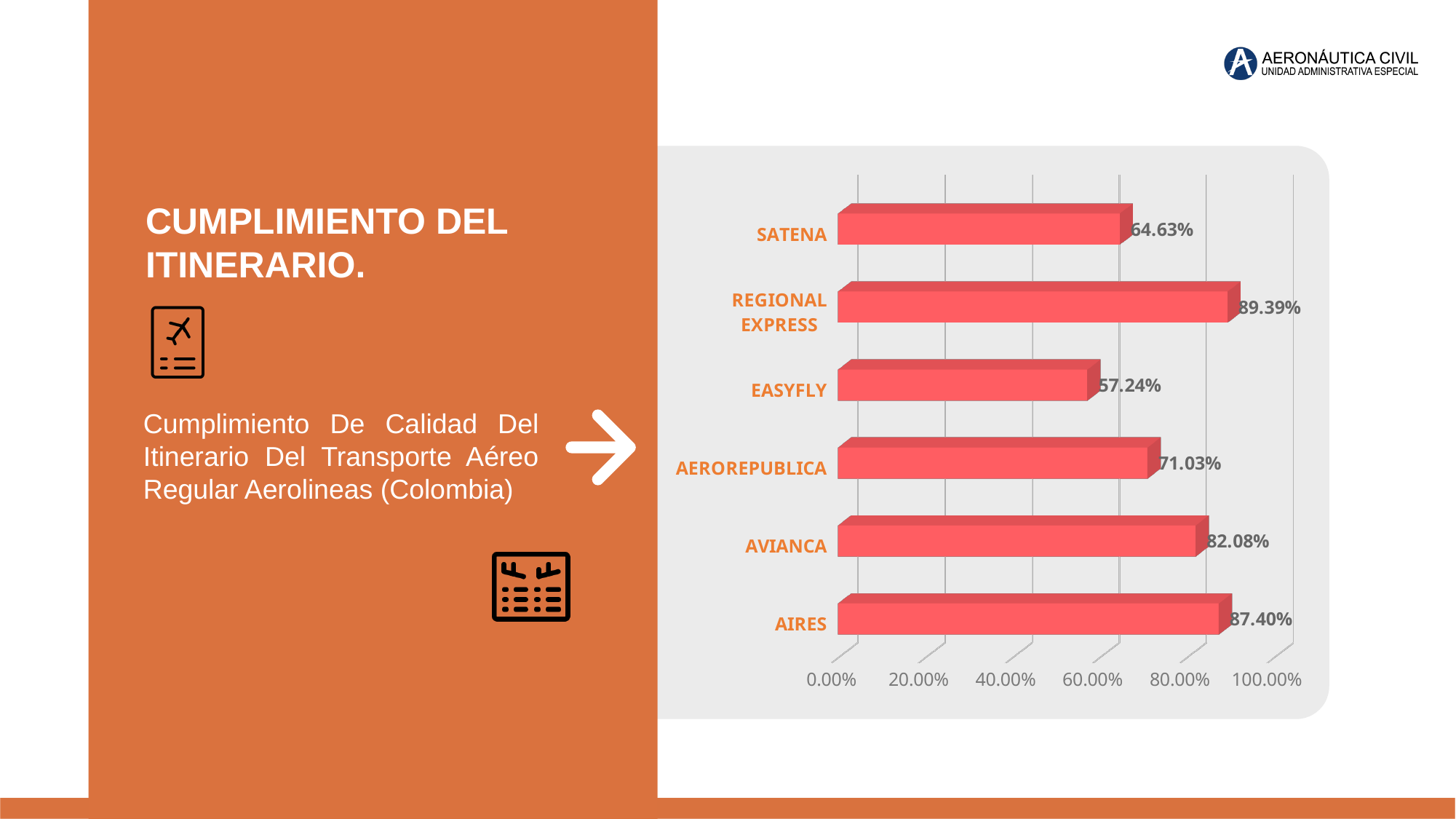
What is the value for EASYFLY? 57.24% What is the value for AEROREPUBLICA? 71.03% Which airline has the lowest value? EASYFLY What is the value for REGIONAL EXPRESS? 89.39% What kind of chart is shown on the slide? bar chart Is the value for AVIANCA greater or less than 80.00%? greater What is the difference between the values for AVIANCA and AIRES? 5.32% How many airlines are shown in the chart? 6 What is the maximum value shown on the horizontal axis? 100.00% Which airline has the highest value? REGIONAL EXPRESS What is the value for SATENA? 64.63% Which is larger, the value for SATENA or the value for AEROREPUBLICA? AEROREPUBLICA